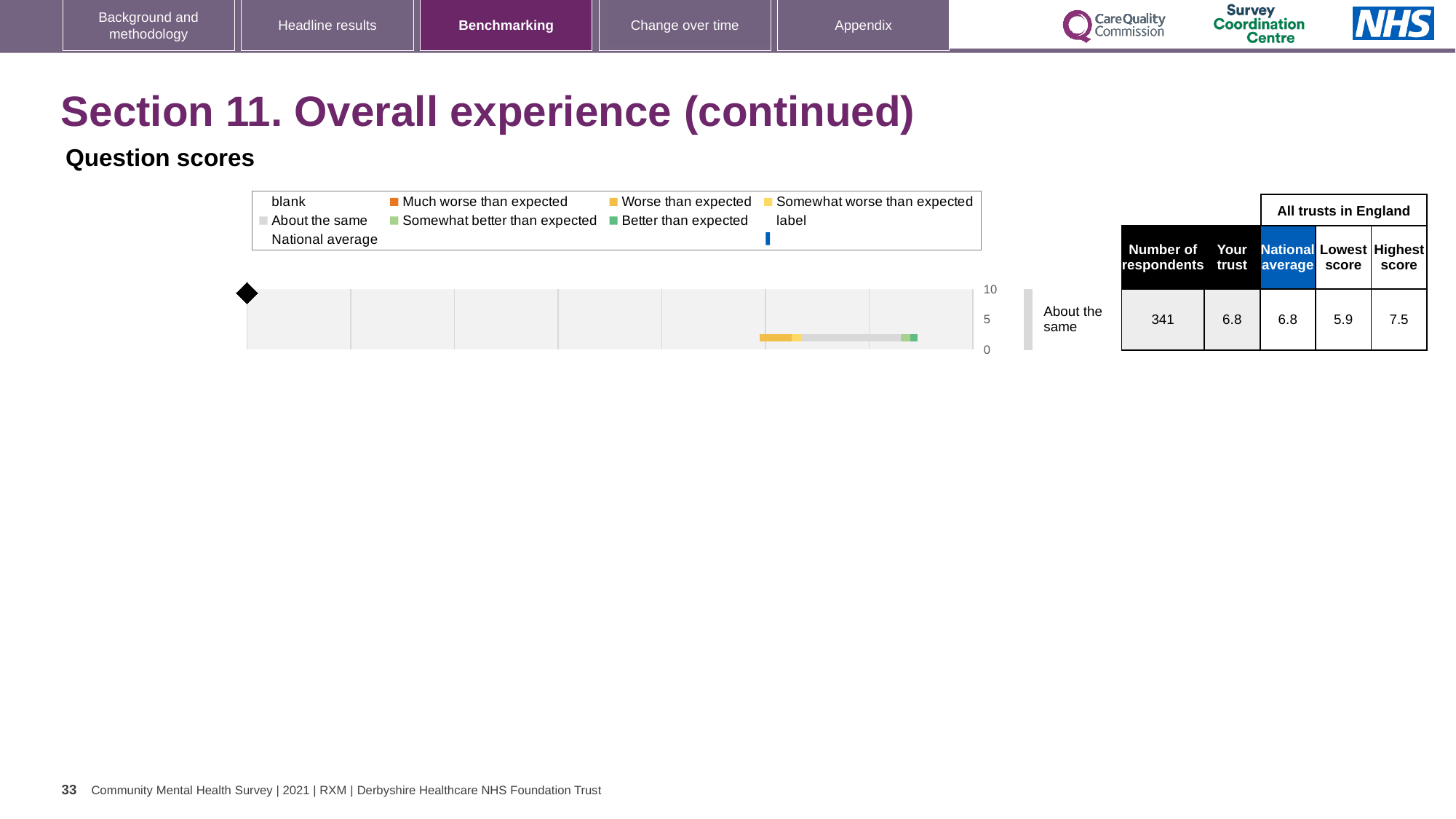
In the table beside the chart, what is the highest score among all trusts in England? 7.5 How many categories (rows) are plotted in the question scores chart? 1 In the table beside the chart, what is the national average score? 6.8 What kind of chart is shown under "Question scores"? bar chart In the table beside the chart, what is the lowest score among all trusts in England? 5.9 What is the difference between the highest score (7.5) and the lowest score (5.9) in the table beside the chart? 1.6 In the table beside the chart, what is the "Your trust" score for the "About the same" row? 6.8 What is the highest value shown on the axis of the question scores chart? 10 Which legend entry is shown in dark orange in the question scores chart? Much worse than expected In the table beside the chart, what is the number of respondents for the "About the same" row? 341 Is the "Your trust" score in the table beside the chart greater or less than 5? greater What is the category label shown next to the bar in the question scores chart? About the same